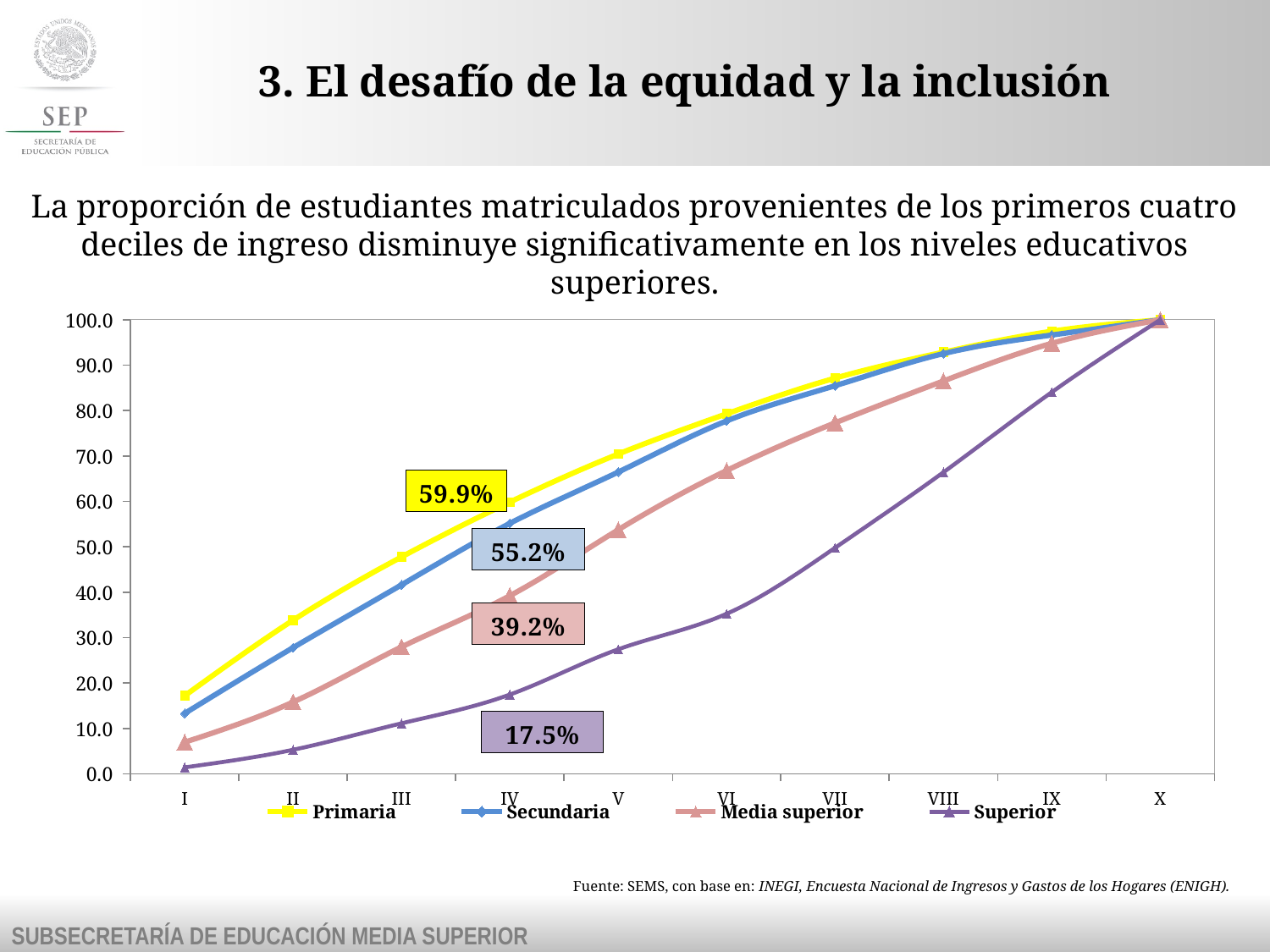
What value is shown in the purple callout box for Superior? 17.5% What is the difference between the Primaria callout value (59.9%) and the Superior callout value (17.5%)? 42.4% Which series has the highest value at decile V? Primaria How many deciles are shown along the x axis? 10 Is the value for Superior at decile I greater or less than 10.0? less How many series does the legend list? 4 What type of chart is shown on the slide? line chart What value is shown in the blue callout box for Secundaria? 55.2% What value is shown in the pink callout box for Media superior? 39.2% Do the values of each series rise or fall from decile I to decile X? rise What value is shown in the yellow callout box for Primaria? 59.9% Which series has the lowest value at decile I? Superior